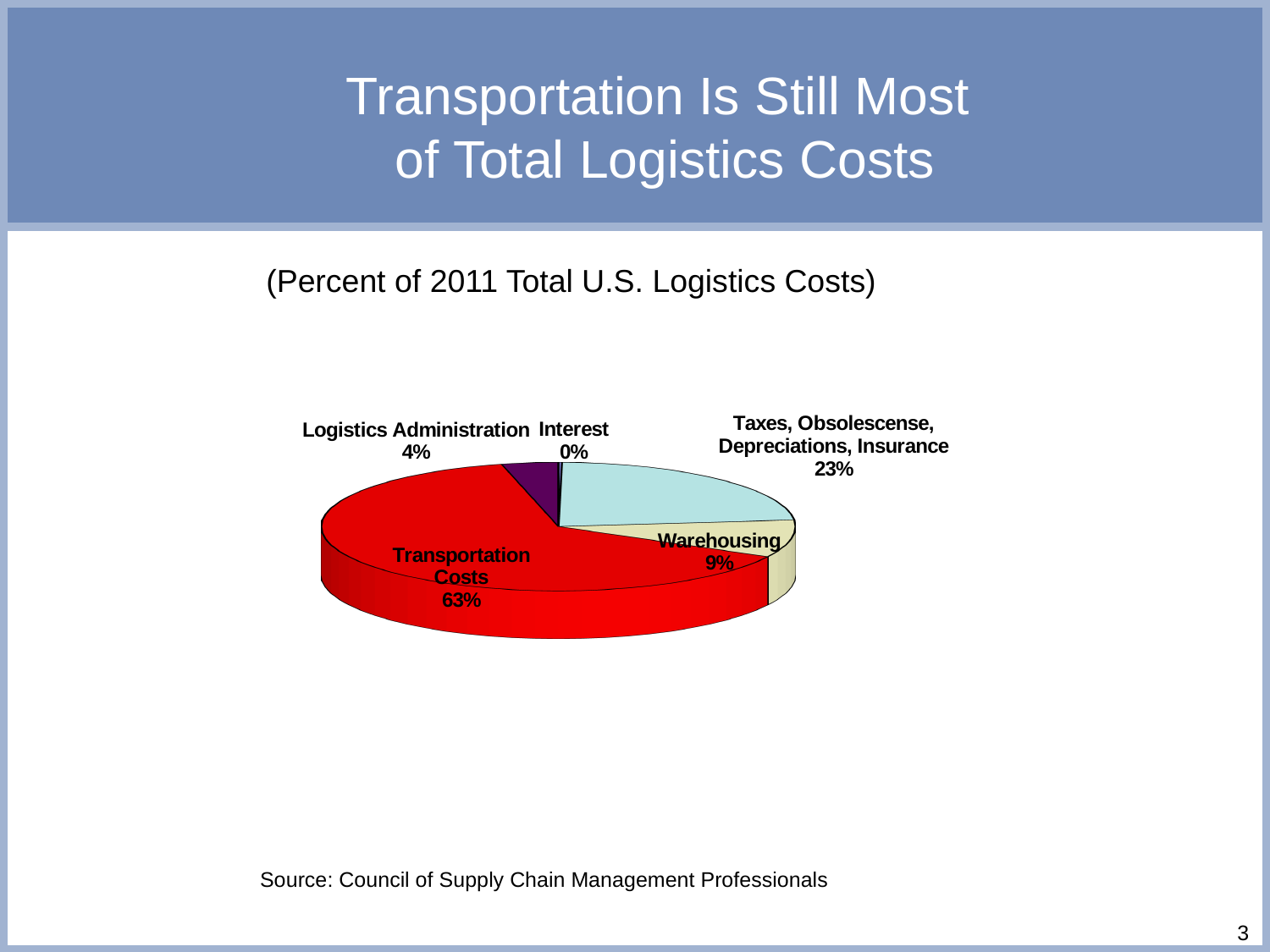
What percentage is shown for Interest? 0% What share of 2011 total U.S. logistics costs is Transportation Costs? 63% What kind of chart is shown on the slide? Pie chart What colour is the Transportation Costs slice? Red What share is shown for Taxes, Obsolescense, Depreciations, Insurance? 23% Which is larger, Warehousing or Logistics Administration? Warehousing What percentage of the pie is Warehousing? 9% What percentage is shown for Logistics Administration? 4% Which category has the smallest share of the pie? Interest How many categories are shown in the pie chart? 5 How many percentage points larger is Transportation Costs than Taxes, Obsolescense, Depreciations, Insurance? 40 Which category has the largest share of the pie? Transportation Costs